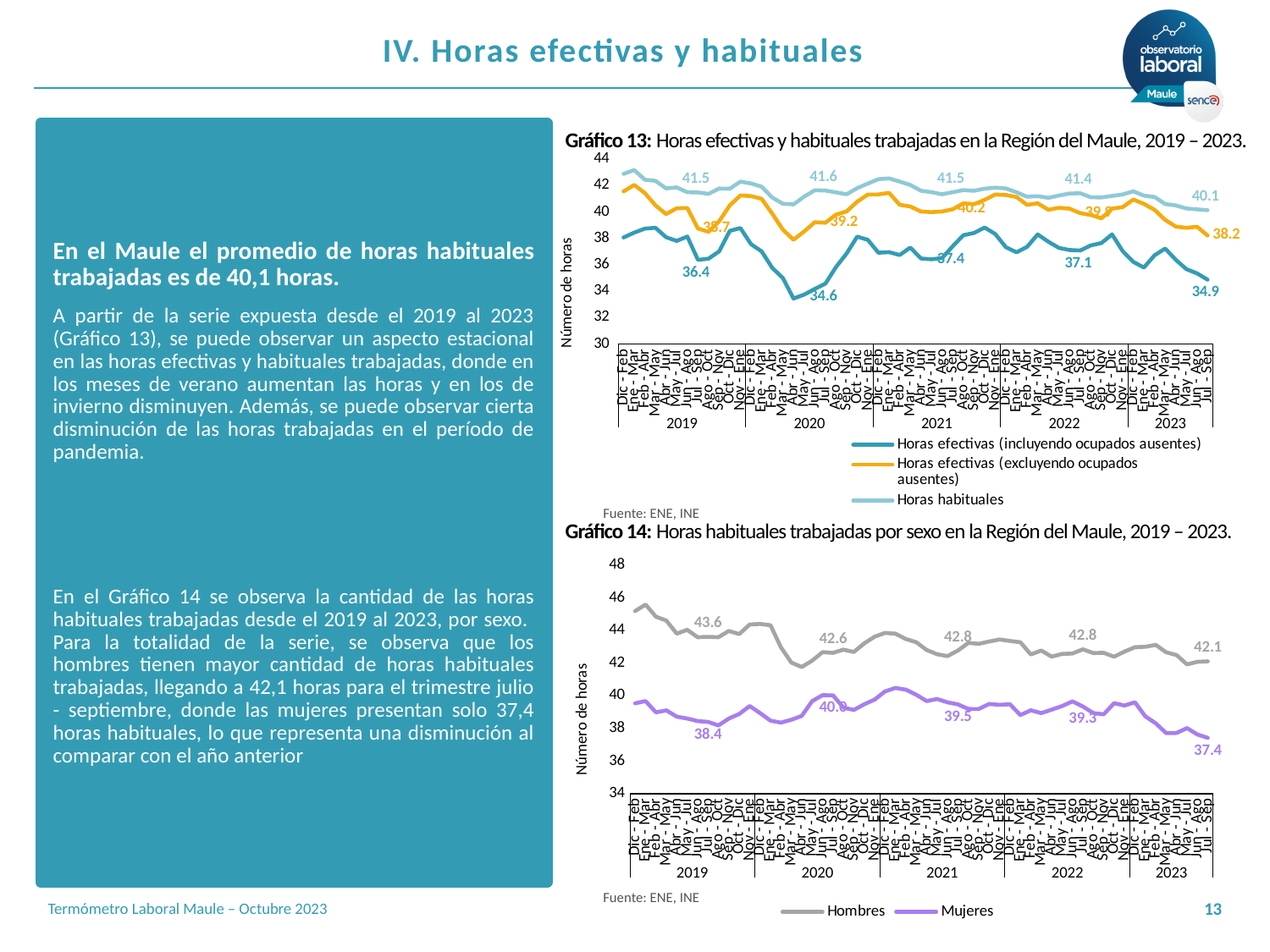
In Gráfico 14, what is the last labelled value for Hombres (2023)? 42.1 In Gráfico 14, which series is higher throughout the period, Hombres or Mujeres? Hombres In Gráfico 14, what is the last labelled value for Mujeres (2023)? 37.4 In Gráfico 13, what is the difference between the 2023 labelled values of Horas habituales (40.1) and Horas efectivas (incluyendo ocupados ausentes) (34.9)? 5.2 In Gráfico 13, what is the labelled value of Horas efectivas (incluyendo ocupados ausentes) in 2020? 34.6 In Gráfico 13, what is the last labelled value of the Horas efectivas (incluyendo ocupados ausentes) series (2023)? 34.9 In Gráfico 13, what is the last labelled value of the Horas efectivas (excluyendo ocupados ausentes) series (2023)? 38.2 In Gráfico 13, how many series does the legend list? 3 What kind of chart is Gráfico 14? line chart In Gráfico 13, what is the last labelled value of the Horas habituales series (2023)? 40.1 What kind of chart is Gráfico 13? line chart In Gráfico 13, which series has the highest values throughout the period? Horas habituales